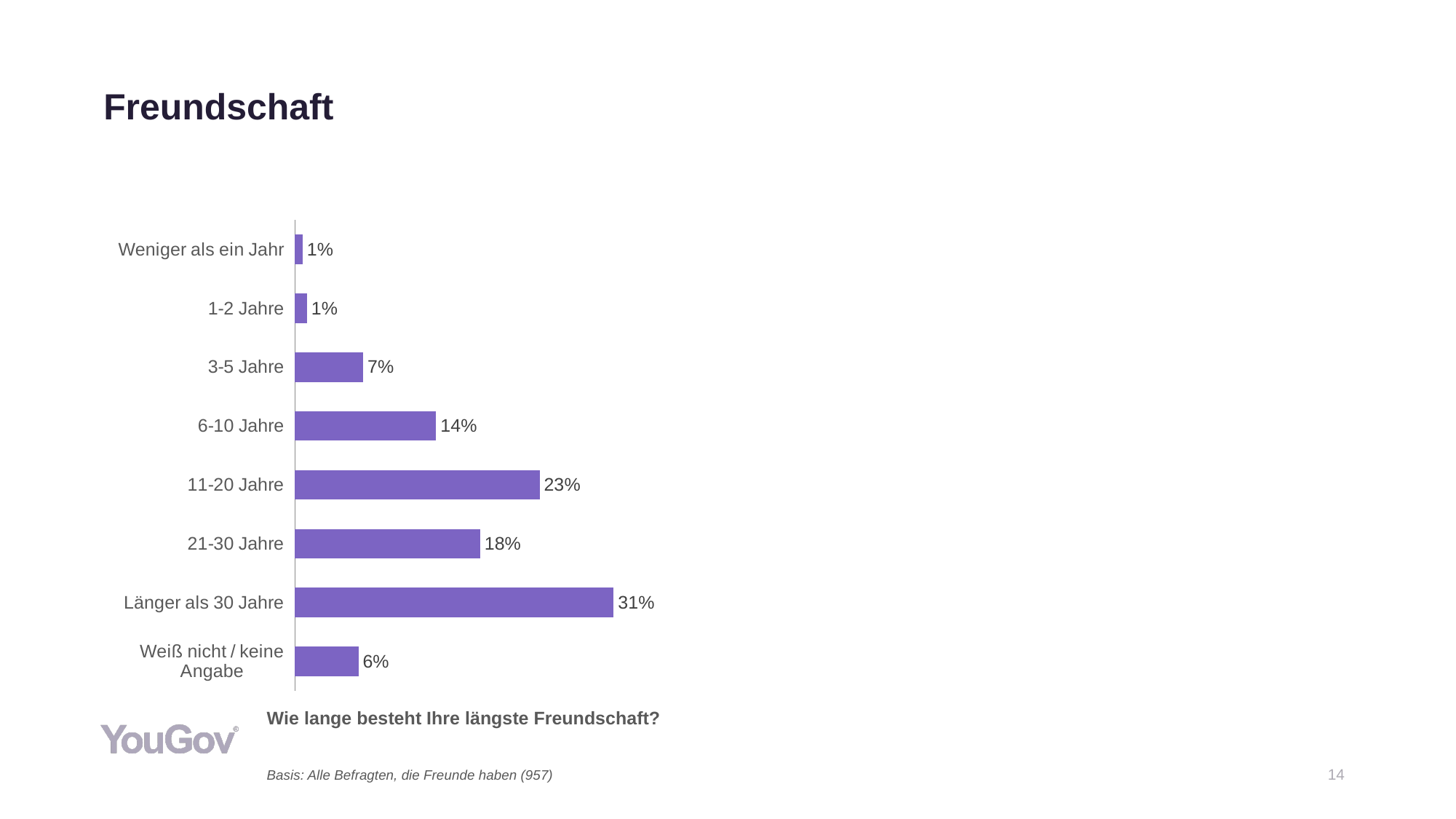
What kind of chart is shown on the slide? Bar chart What is the value shown for '11-20 Jahre'? 23% What is the value shown for '6-10 Jahre'? 14% What is the difference between the values for '21-30 Jahre' and '6-10 Jahre'? 4% What is the survey question shown below the chart? Wie lange besteht Ihre längste Freundschaft? Which category has the highest value? Länger als 30 Jahre What is the difference between the values for 'Länger als 30 Jahre' and '11-20 Jahre'? 8% What percentage of respondents said their longest friendship has lasted 'Länger als 30 Jahre'? 31% What is the value shown for 'Weiß nicht / keine Angabe'? 6% What is the title of the slide? Freundschaft How many categories are shown in the chart? 8 Which is larger, the value for '11-20 Jahre' or the value for '21-30 Jahre'? 11-20 Jahre